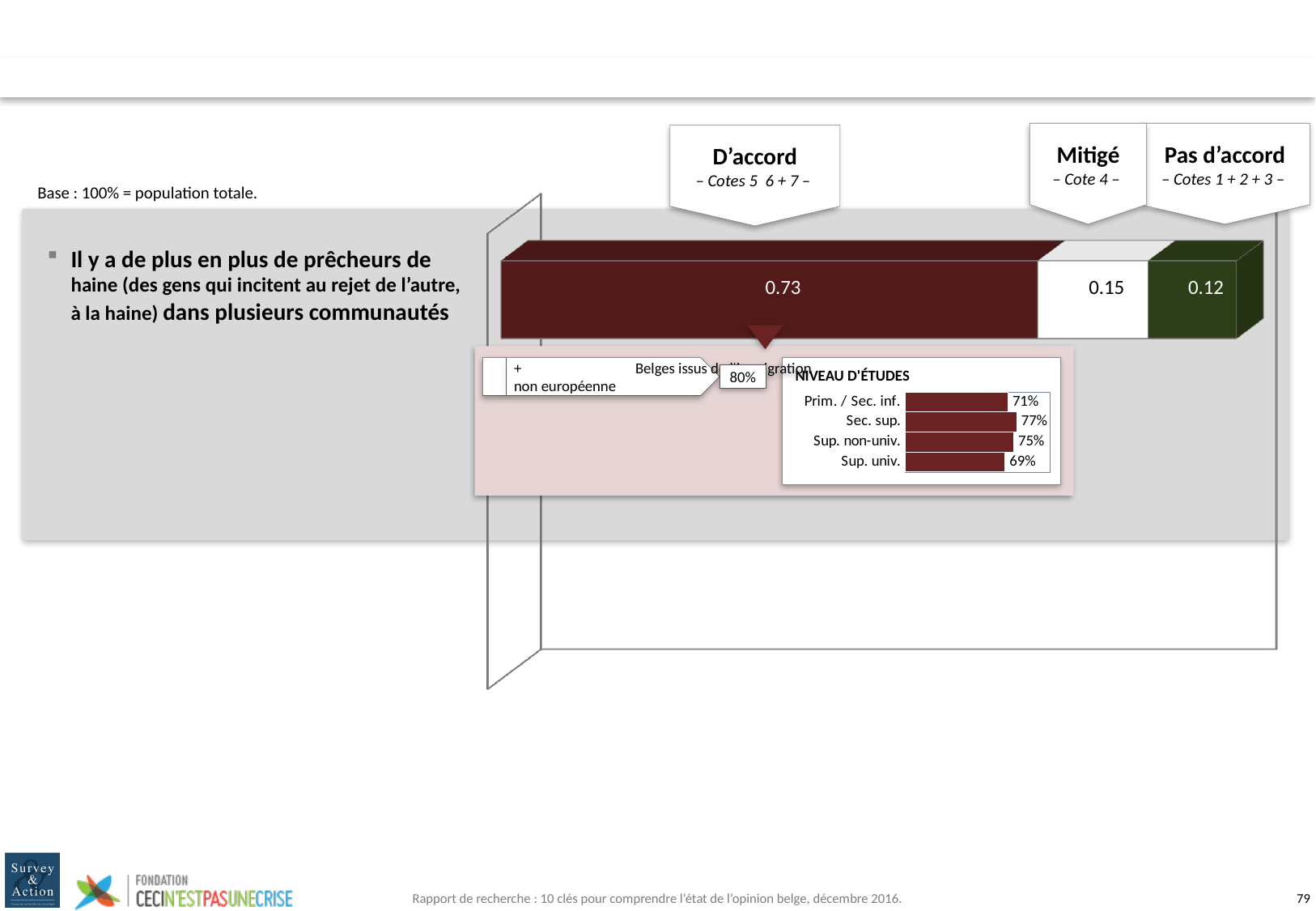
In the 'NIVEAU D'ÉTUDES' chart, how many categories are shown? 4 In the main stacked bar chart, what is the difference between the 'D'accord' and 'Pas d'accord' values? 0.61 In the main stacked bar chart, which segment is the smallest? Pas d'accord In the main stacked bar chart, what is the total of the three segments? 1.00 In the 'NIVEAU D'ÉTUDES' chart, which category has the lowest value? Sup. univ. In the 'NIVEAU D'ÉTUDES' chart, which is larger: 'Prim. / Sec. inf.' or 'Sup. non-univ.'? Sup. non-univ. In the main stacked bar chart, which segment is the largest? D'accord In the main stacked bar chart, what is the value for the 'D'accord' segment? 0.73 In the 'NIVEAU D'ÉTUDES' chart, what is the value for 'Sec. sup.'? 77% In the main stacked bar chart, what is the value for the 'Mitigé' segment? 0.15 In the main stacked bar chart, what is the value for the 'Pas d'accord' segment? 0.12 In the 'NIVEAU D'ÉTUDES' chart, what is the value for 'Sup. univ.'? 69%